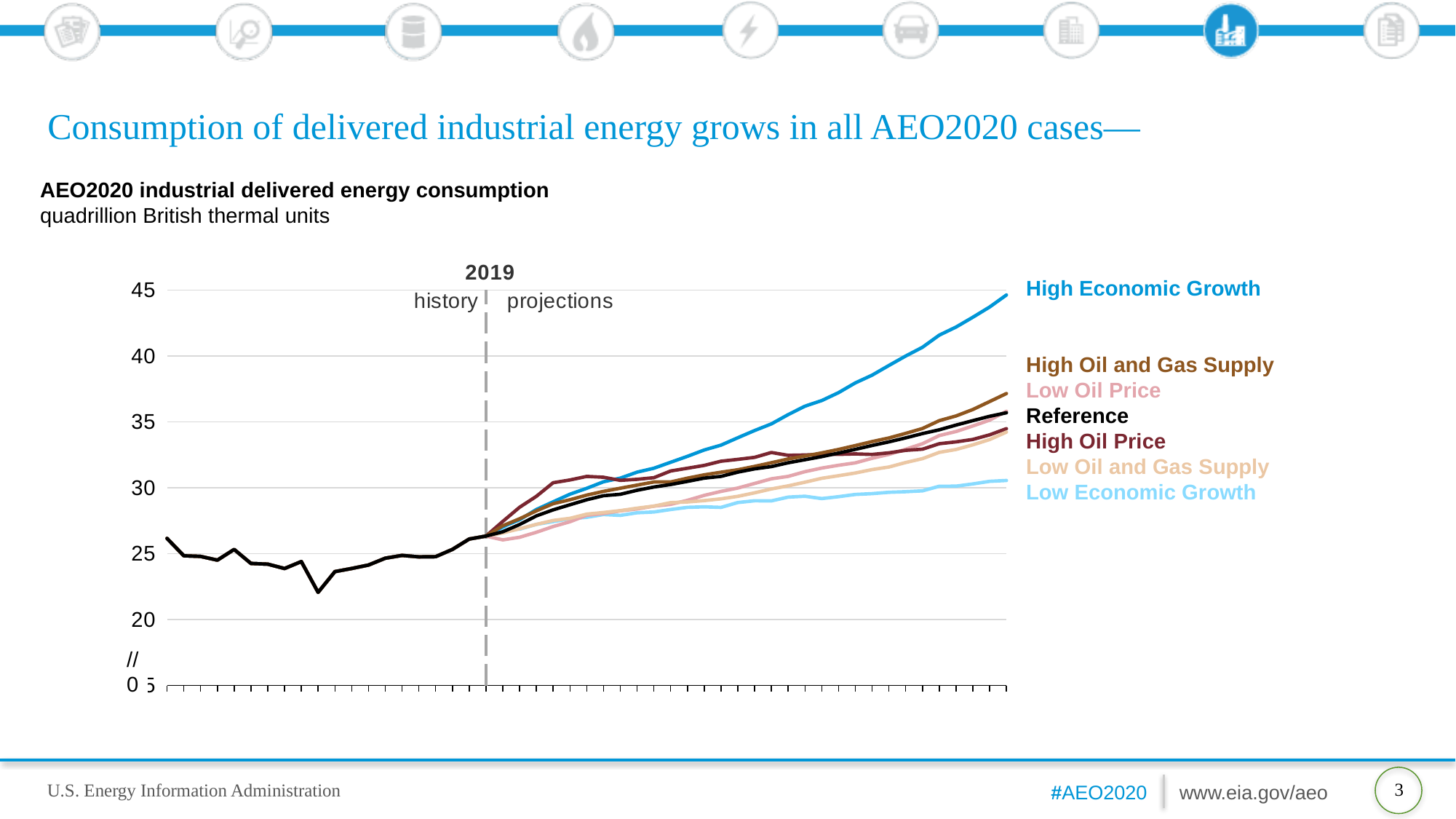
At the end of the projection period, is the value for High Economic Growth greater or less than 40? greater How many cases (series) are labelled on the chart? 7 What kind of chart is shown on the slide? line chart At the end of the projection period, is the value for High Oil and Gas Supply greater or less than 40? less At the end of the projection period, is the value for Low Economic Growth greater or less than 35? less Which case has the highest industrial delivered energy consumption at the end of the projection period? High Economic Growth Do the projected values generally rise or fall over the projection period? rise Which case has the lowest industrial delivered energy consumption at the end of the projection period? Low Economic Growth Which year separates history from projections on the chart? 2019 At the end of the projection period, which is larger: High Oil and Gas Supply or Low Oil and Gas Supply? High Oil and Gas Supply What unit is the chart measured in? quadrillion British thermal units